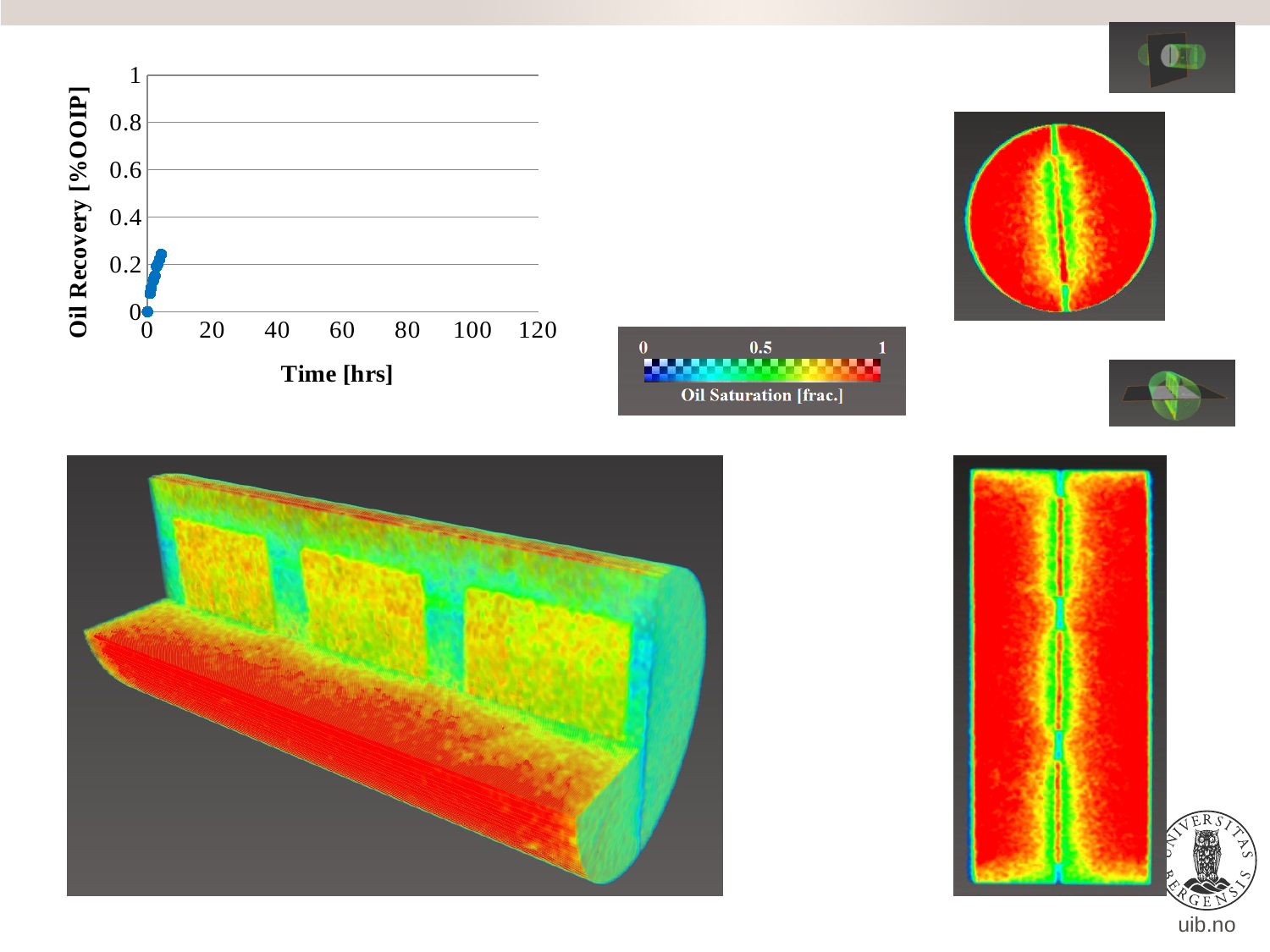
What kind of chart is shown on the slide? scatter chart Is the oil recovery value at time 0 hrs greater or less than 0.2? less What is the title of the horizontal axis of the chart? Time [hrs] Is the highest oil recovery value plotted greater or less than 0.6? less What is the maximum value shown on the Time [hrs] axis? 120 Do the oil recovery values rise or fall as time increases along the x axis? rise What is the title of the vertical axis of the chart? Oil Recovery [%OOIP] Is the highest oil recovery value plotted greater or less than 0.4? less